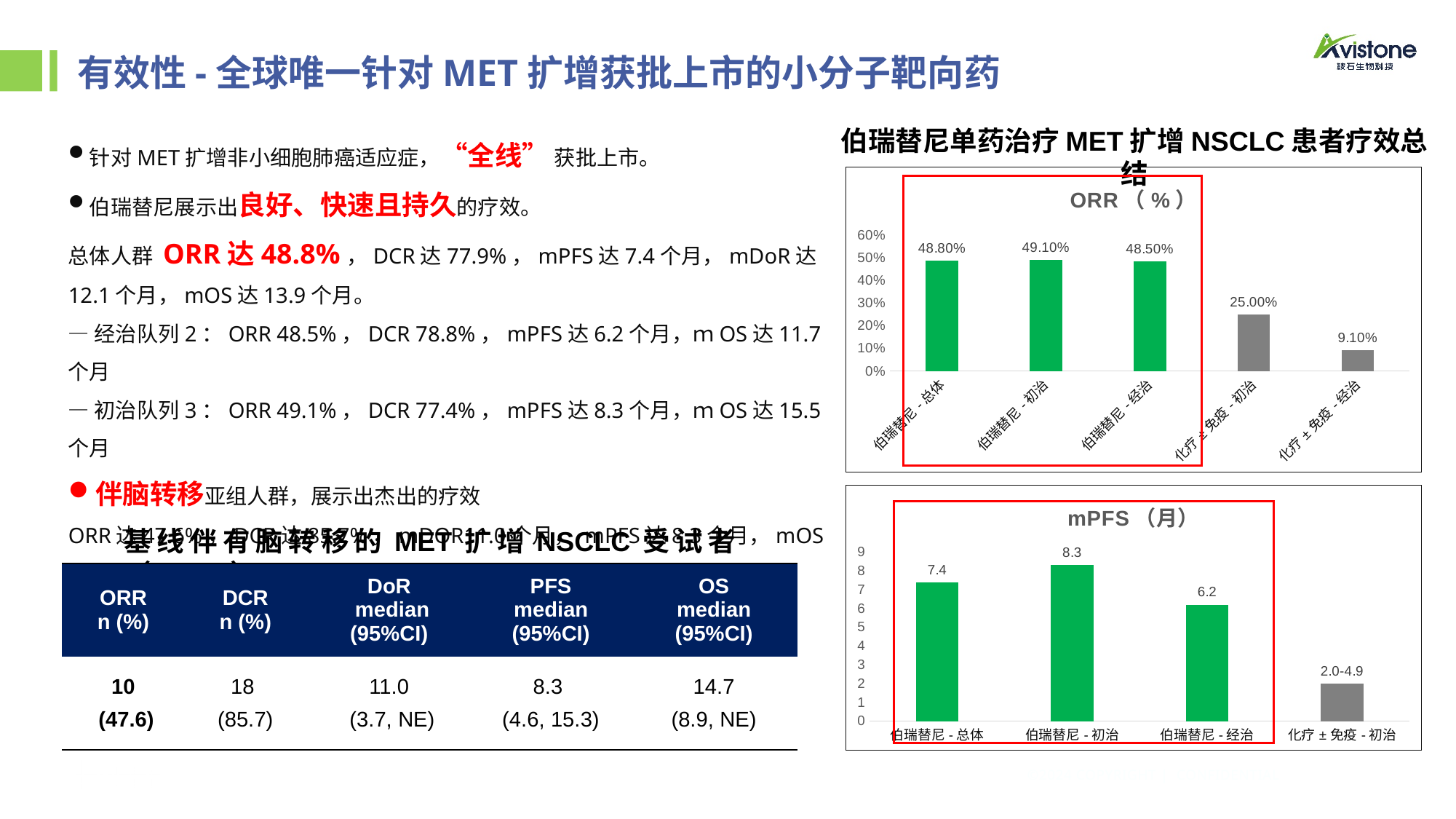
In the ORR (%) chart, what is the difference between 伯瑞替尼 - 初治 and 化疗 ± 免疫 - 初治? 24.10% In the mPFS (月) chart, which category has the highest value? 伯瑞替尼 - 初治 In the mPFS (月) chart, what is the difference between 伯瑞替尼 - 总体 and 伯瑞替尼 - 经治? 1.2 In the ORR (%) chart, what is the value for 伯瑞替尼 - 总体? 48.80% In the mPFS (月) chart, what is the label shown for 化疗 ± 免疫 - 初治? 2.0-4.9 In the ORR (%) chart, how many bars are plotted? 5 In the mPFS (月) chart, which is larger, 伯瑞替尼 - 总体 or 伯瑞替尼 - 经治? 伯瑞替尼 - 总体 In the ORR (%) chart, what is the value for 化疗 ± 免疫 - 经治? 9.10% In the ORR (%) chart, is the value for 化疗 ± 免疫 - 初治 greater or less than 30%? less In the mPFS (月) chart, what is the value for 伯瑞替尼 - 初治? 8.3 What type of chart is the mPFS (月) chart? bar chart In the ORR (%) chart, which category has the lowest value? 化疗 ± 免疫 - 经治